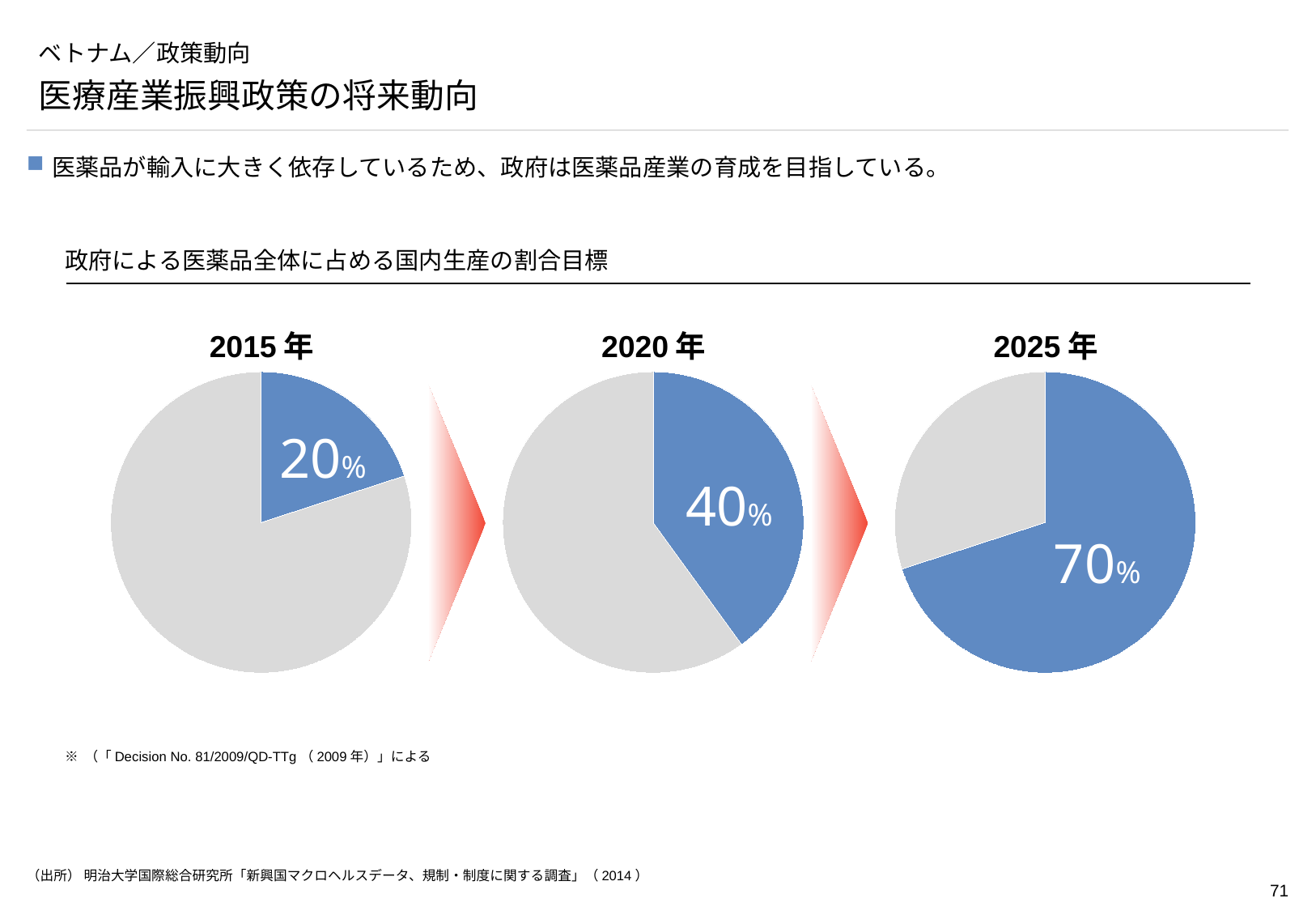
Do the labelled blue-slice percentages rise or fall from the 2015年 chart to the 2025年 chart? Rise Which pie chart has the largest blue slice: 2015年, 2020年 or 2025年? 2025年 By how many percentage points does the blue slice in the 2020年 pie chart exceed the blue slice in the 2015年 pie chart? 20 Which pie chart has the smallest blue slice: 2015年, 2020年 or 2025年? 2015年 What is the title written above the three pie charts? 政府による医薬品全体に占める国内生産の割合目標 In the 2015年 pie chart, what percentage is shown for the blue slice? 20% In the 2020年 pie chart, what percentage is shown for the blue slice? 40% How many pie charts are shown on the slide? 3 Is the blue slice larger in the 2020年 pie chart or the 2015年 pie chart? 2020年 By how many percentage points does the blue slice in the 2025年 pie chart exceed the blue slice in the 2020年 pie chart? 30 In the 2025年 pie chart, what percentage is shown for the blue slice? 70% What kind of charts are shown on the slide? Pie charts